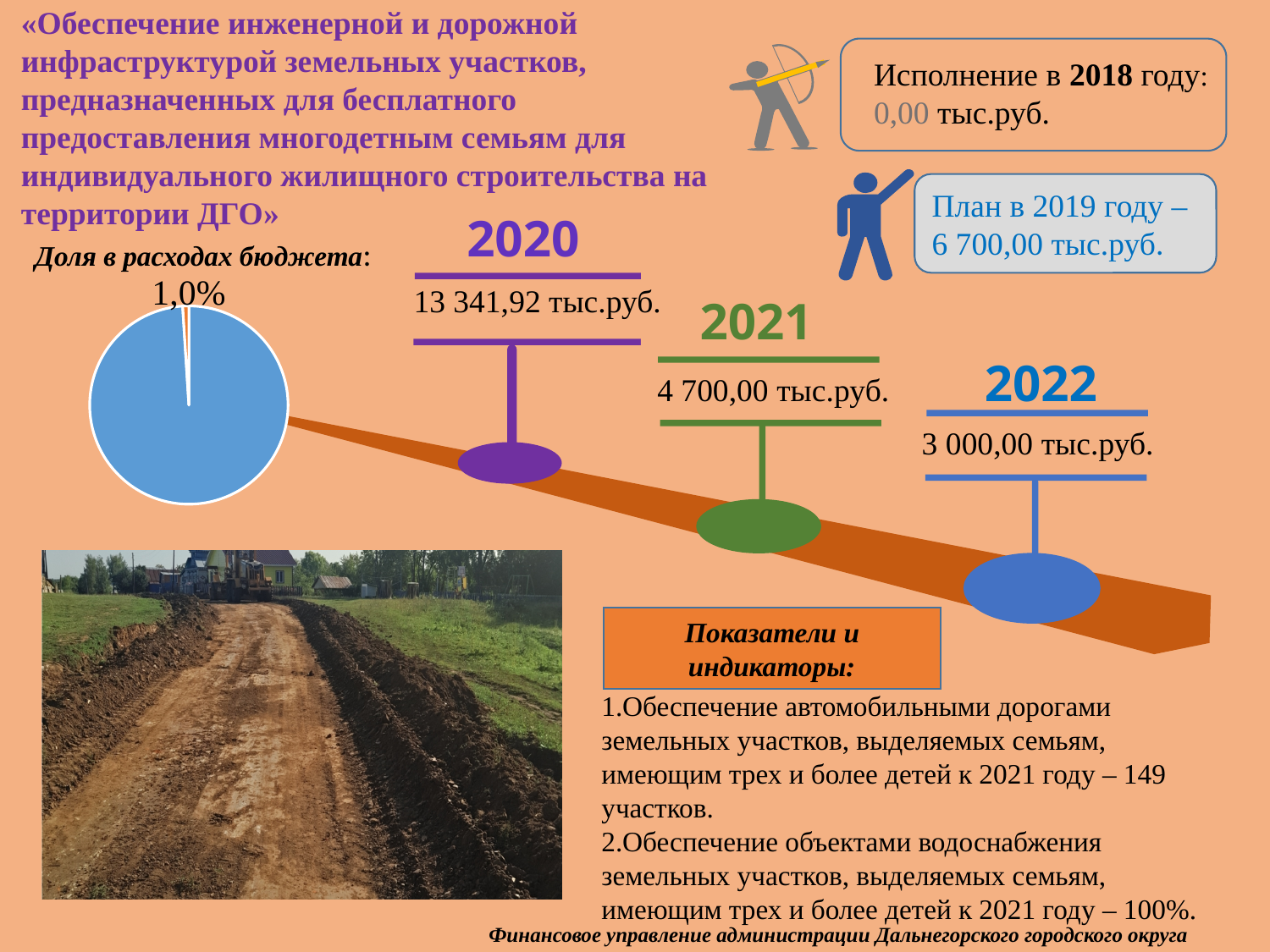
What is the heading printed above the pie chart? Доля в расходах бюджета On the timeline infographic, which year has the lowest amount? 2022 On the timeline infographic, which year has the highest amount? 2020 How many slices does the pie chart «Доля в расходах бюджета» have? 2 On the timeline infographic, what amount is shown for 2022? 3 000,00 тыс.руб. On the timeline infographic, do the amounts rise or fall from 2020 to 2022? fall On the timeline infographic, what amount is shown for 2021? 4 700,00 тыс.руб. In the pie chart «Доля в расходах бюджета», what share is printed for the small slice? 1,0% What kind of chart is shown under the heading «Доля в расходах бюджета»? pie chart On the timeline infographic, what is the difference between the 2021 and 2022 amounts? 1 700,00 тыс.руб. What colour is the large slice of the pie chart «Доля в расходах бюджета»? blue On the timeline infographic, what amount is shown for 2020? 13 341,92 тыс.руб.